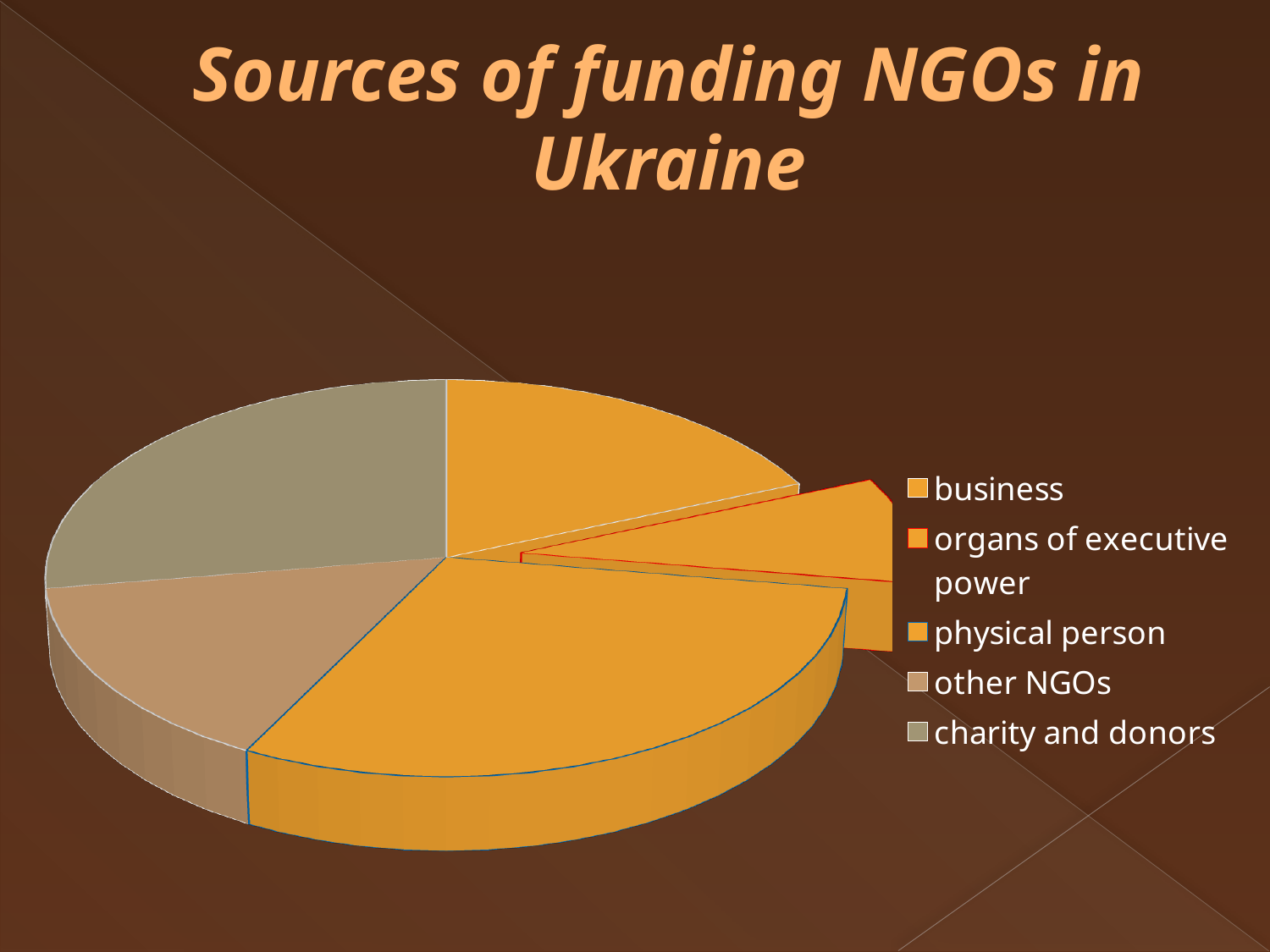
Which funding source has the smallest slice of the pie? organs of executive power Which funding source has the largest slice of the pie? physical person Which slice is larger: physical person or organs of executive power? physical person Which slice is pulled out (exploded) from the rest of the pie? organs of executive power How many categories does the pie chart show? 5 Which slice is larger: physical person or charity and donors? physical person Which slice is larger: business or organs of executive power? business What is the title of the slide? Sources of funding NGOs in Ukraine What kind of chart is shown on the slide? pie chart